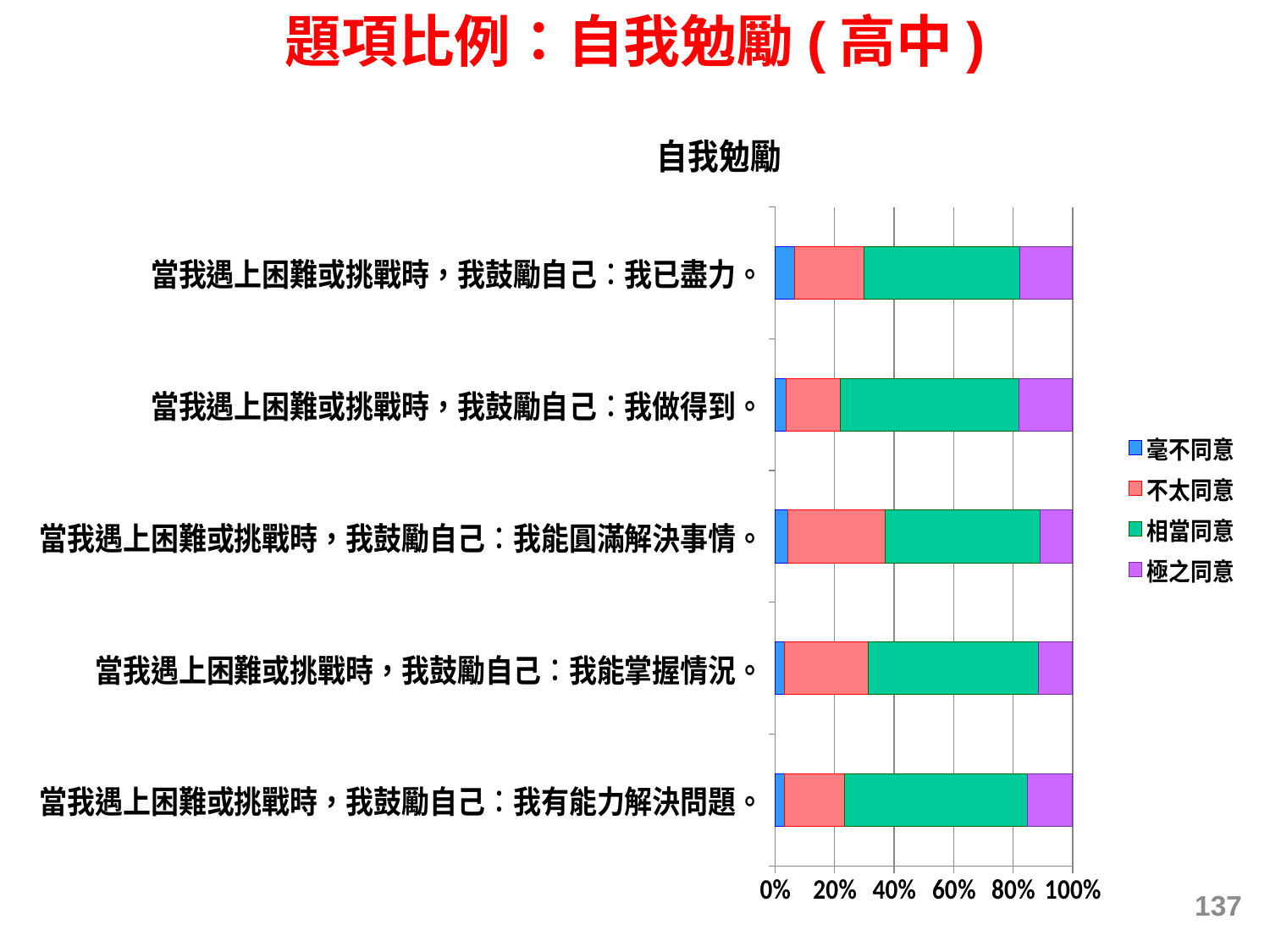
Is the 相當同意 share for 「我做得到」 greater or less than 40%? greater Which item has the largest 不太同意 segment? 當我遇上困難或挑戰時，我鼓勵自己：我能圓滿解決事情。 Is the 不太同意 share for 「我能圓滿解決事情」 greater or less than 20%? greater Which item has the largest 毫不同意 segment? 當我遇上困難或挑戰時，我鼓勵自己：我已盡力。 What is the title of the chart? 自我勉勵 What kind of chart is shown on the slide? Stacked bar chart Which legend entry is shown in green? 相當同意 How many question items (categories) are plotted in the chart? 5 How many series does the legend list? 4 Which has a larger 不太同意 share: 「我能圓滿解決事情」 or 「我做得到」? 我能圓滿解決事情 Which has a larger 毫不同意 share: 「我已盡力」 or 「我做得到」? 我已盡力 Is the 極之同意 share for 「我已盡力」 greater or less than 20%? less